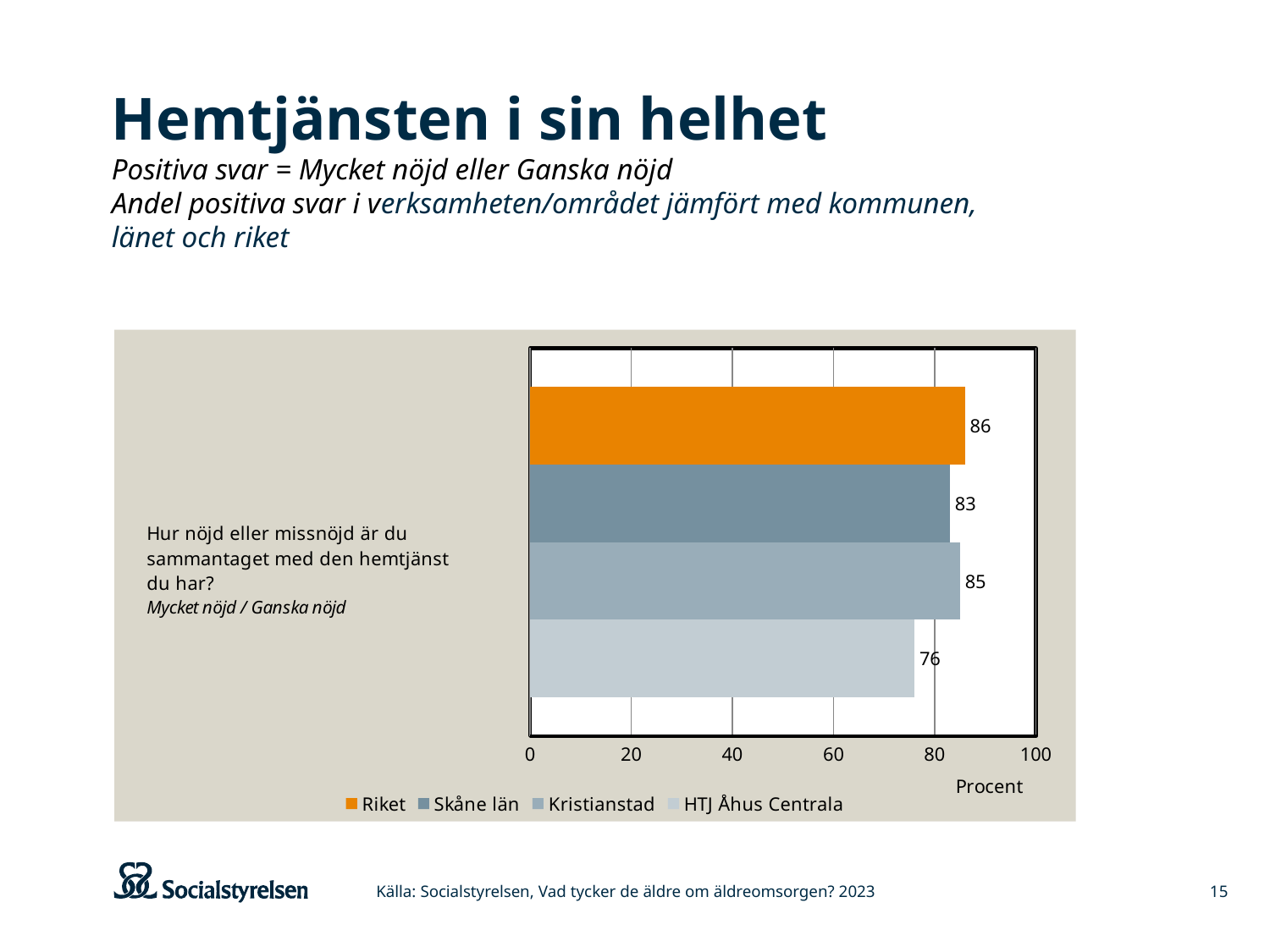
Which series has the highest value? Riket What kind of chart is shown on the slide? bar chart What is the difference between the values for Riket and HTJ Åhus Centrala? 10 Is the value for HTJ Åhus Centrala greater or less than 80? less What is the value for Skåne län? 83 What is the value for HTJ Åhus Centrala? 76 What is the difference between the values for Kristianstad and Skåne län? 2 How many series does the legend list? 4 Which series has the lowest value? HTJ Åhus Centrala What is the value for Kristianstad? 85 Which is larger, the value for Kristianstad or the value for HTJ Åhus Centrala? Kristianstad What is the value for Riket? 86